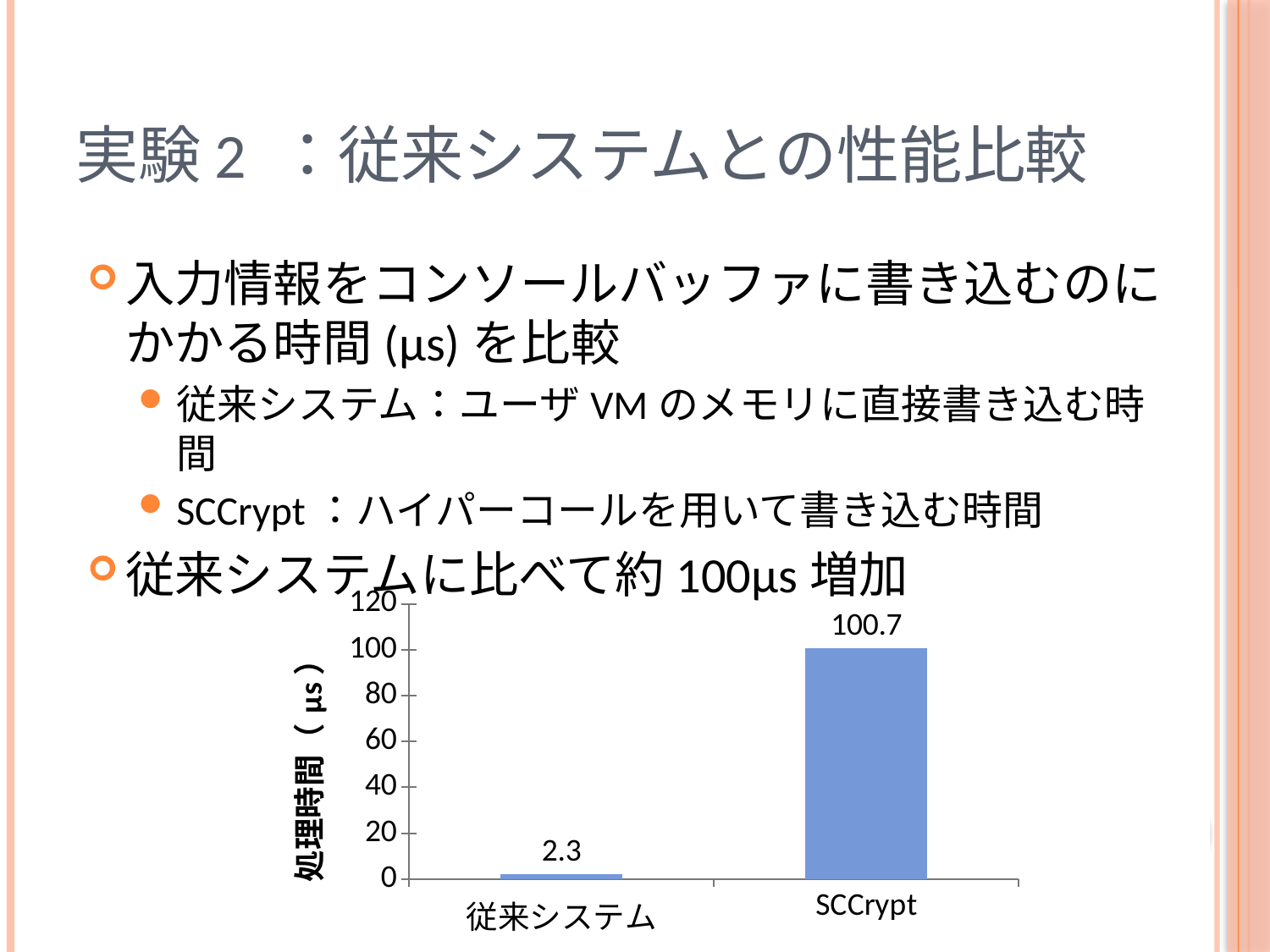
What kind of chart is shown on the slide? bar chart Which category has the highest value? SCCrypt How many categories are shown on the x axis? 2 Is the value for 従来システム greater or less than 20? less What is the value for SCCrypt? 100.7 Is the value for SCCrypt greater or less than 80? greater What is the label of the vertical axis? 処理時間（μs） Which category has the lowest value? 従来システム What is the difference between the values for SCCrypt and 従来システム? 98.4 What is the maximum value shown on the vertical axis? 120 What is the value for 従来システム? 2.3 Which is larger, the value for SCCrypt or the value for 従来システム? SCCrypt